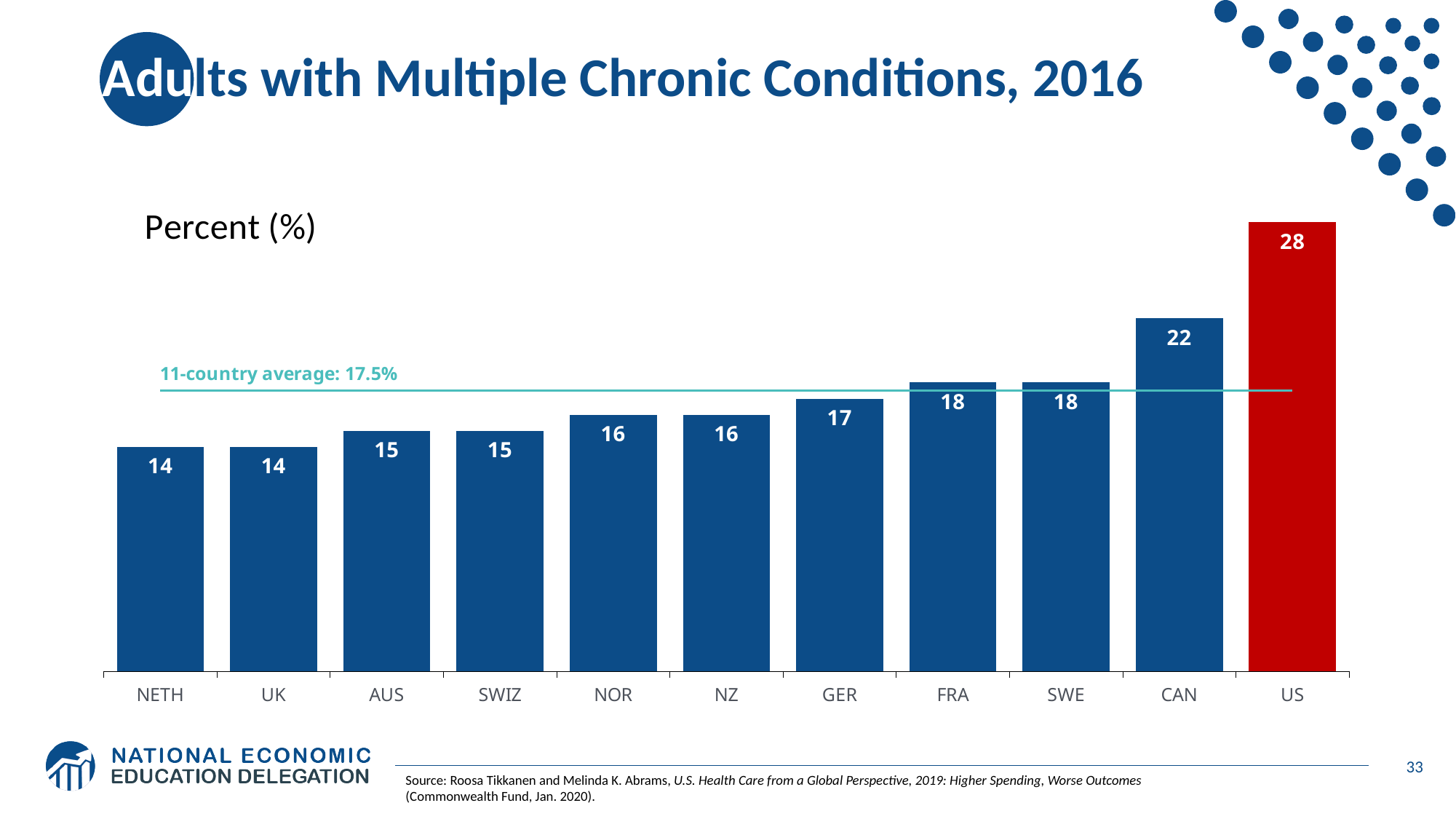
What kind of chart is shown on the slide? bar chart What is the difference between the values for FRA and NETH? 4 Which is larger, the value for CAN or the value for SWE? CAN What is the 11-country average shown on the chart? 17.5% What is the value for CAN? 22 Do the values rise or fall moving from left to right along the x axis? rise What is the value for the US? 28 Which country's bar is coloured red? US What is the difference between the values for the US and CAN? 6 How many countries are shown on the chart? 11 Which country has the highest value? US What is the value for GER? 17